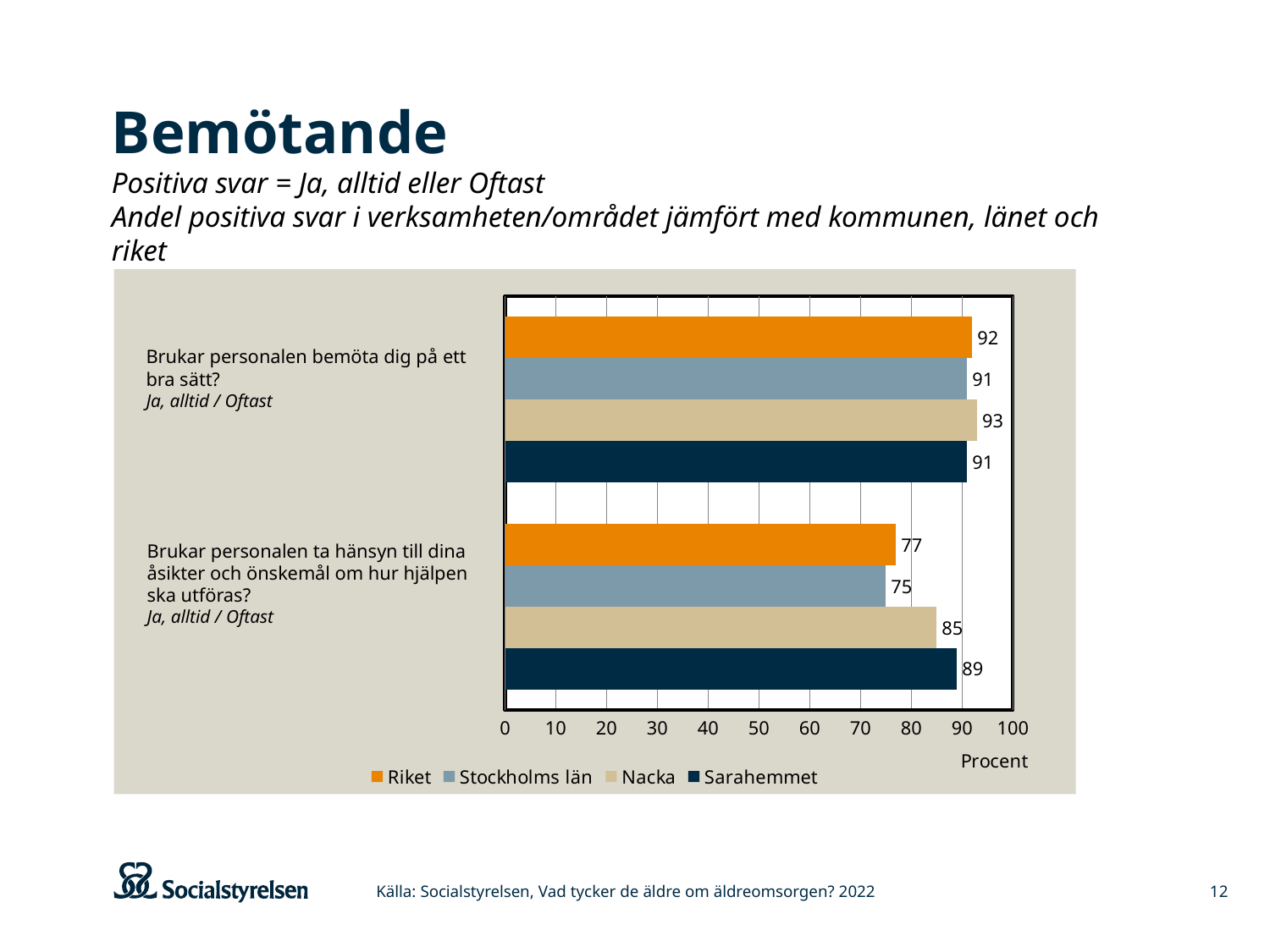
What is the difference between Sarahemmet and Stockholms län on the question "Brukar personalen ta hänsyn till dina åsikter och önskemål om hur hjälpen ska utföras?"? 14 Is the value for Stockholms län on the question "Brukar personalen ta hänsyn till dina åsikter och önskemål om hur hjälpen ska utföras?" greater or less than 80? less What is the value for Nacka on the question "Brukar personalen ta hänsyn till dina åsikter och önskemål om hur hjälpen ska utföras?"? 85 Which series has the highest value on the question "Brukar personalen bemöta dig på ett bra sätt?"? Nacka How many questions (categories) are shown on the chart? 2 Which series has the lowest value on the question "Brukar personalen ta hänsyn till dina åsikter och önskemål om hur hjälpen ska utföras?"? Stockholms län What is the label on the horizontal axis of the chart? Procent What is the value for Sarahemmet on the question "Brukar personalen ta hänsyn till dina åsikter och önskemål om hur hjälpen ska utföras?"? 89 Which is larger on the question "Brukar personalen ta hänsyn till dina åsikter och önskemål om hur hjälpen ska utföras?": Riket or Nacka? Nacka What kind of chart is shown on the slide? bar chart What is the value for Riket on the question "Brukar personalen bemöta dig på ett bra sätt?"? 92 How many series does the legend list? 4